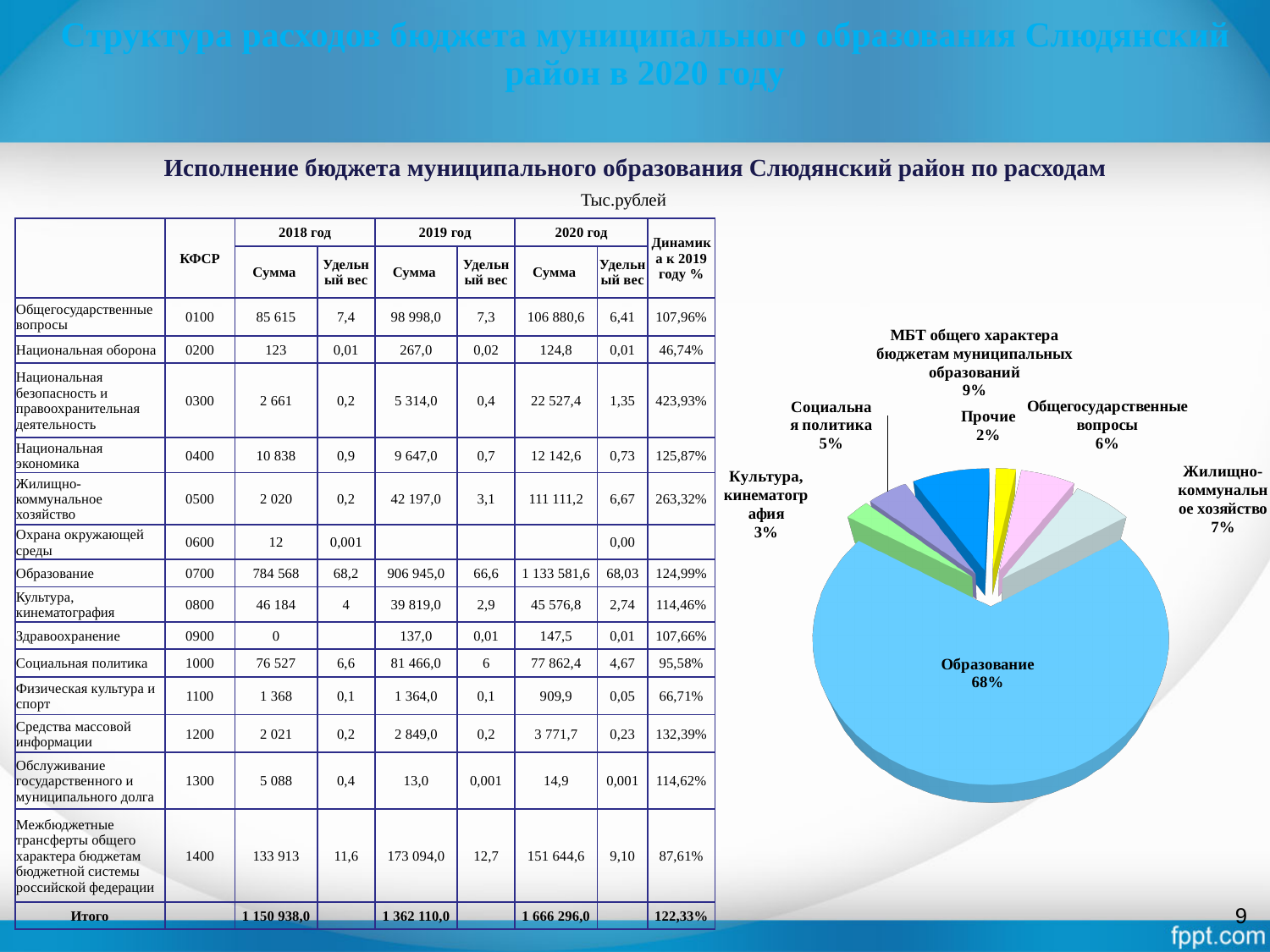
Which slice of the pie chart is the largest? Образование In the pie chart, what share does Социальная политика have? 5% In the pie chart, what share does Жилищно-коммунальное хозяйство have? 7% How many slices does the pie chart have? 7 In the pie chart, what share does Прочие have? 2% Which slice of the pie chart is the smallest? Прочие In the pie chart, what share does Образование have? 68% In the pie chart, which is larger: Общегосударственные вопросы or Социальная политика? Общегосударственные вопросы What kind of chart is shown on the right side of the slide? pie chart In the pie chart, what is the difference in percentage points between Образование and МБТ общего характера бюджетам муниципальных образований? 59 In the pie chart, what share does Культура, кинематография have? 3% In the pie chart, what share does МБТ общего характера бюджетам муниципальных образований have? 9%